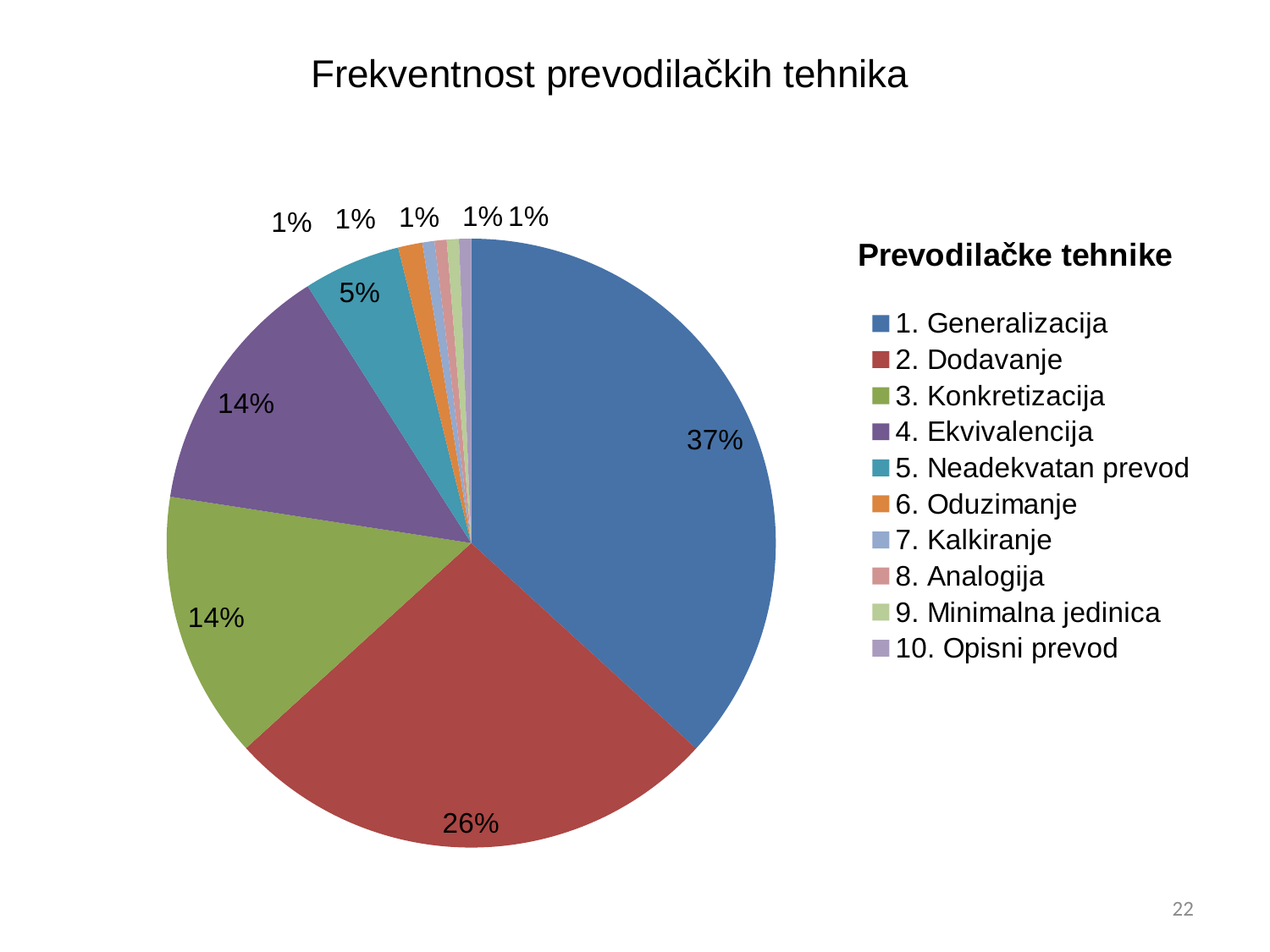
What is the heading shown above the legend of the chart? Prevodilačke tehnike How many categories does the legend of the pie chart list? 10 What share of the pie does 1. Generalizacija take? 37% What is the value shown for 5. Neadekvatan prevod? 5% Which category has the largest slice of the pie? 1. Generalizacija What is the value shown for 3. Konkretizacija? 14% What is the difference in percentage points between 1. Generalizacija and 2. Dodavanje? 11 What is the title of the chart? Prevodilačke tehnike What kind of chart is shown on the slide? pie chart What is the value shown for 6. Oduzimanje? 1% What share of the pie does 2. Dodavanje take? 26% Which is larger, the slice for 2. Dodavanje or the slice for 4. Ekvivalencija? 2. Dodavanje